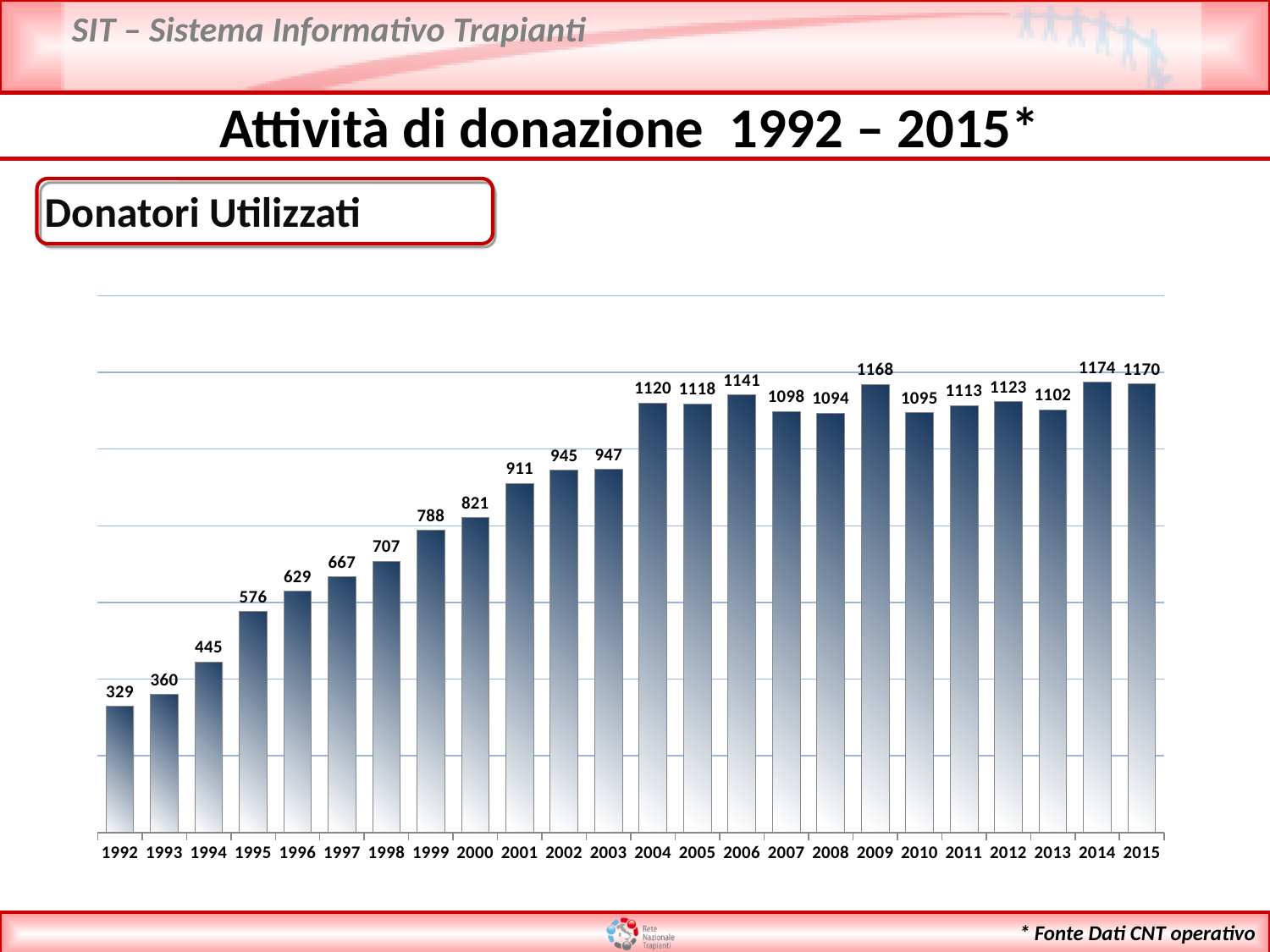
What is the difference between the values for 2015 and 1992 in the Donatori Utilizzati chart? 841 Which year has the larger value in the Donatori Utilizzati chart, 2003 or 2004? 2004 What is the value for 2009 in the Donatori Utilizzati chart? 1168 Which year has the lowest value in the Donatori Utilizzati chart? 1992 Which year has the larger value in the Donatori Utilizzati chart, 1995 or 1999? 1999 Do the values in the Donatori Utilizzati chart generally rise or fall from 1992 to 2015? Rise What is the value for 1992 in the Donatori Utilizzati chart? 329 What kind of chart is used to show Donatori Utilizzati? Bar chart What is the value for 2001 in the Donatori Utilizzati chart? 911 How many years are shown on the x axis of the Donatori Utilizzati chart? 24 Which year has the highest value in the Donatori Utilizzati chart? 2014 What is the difference between the values for 2009 and 2008 in the Donatori Utilizzati chart? 74